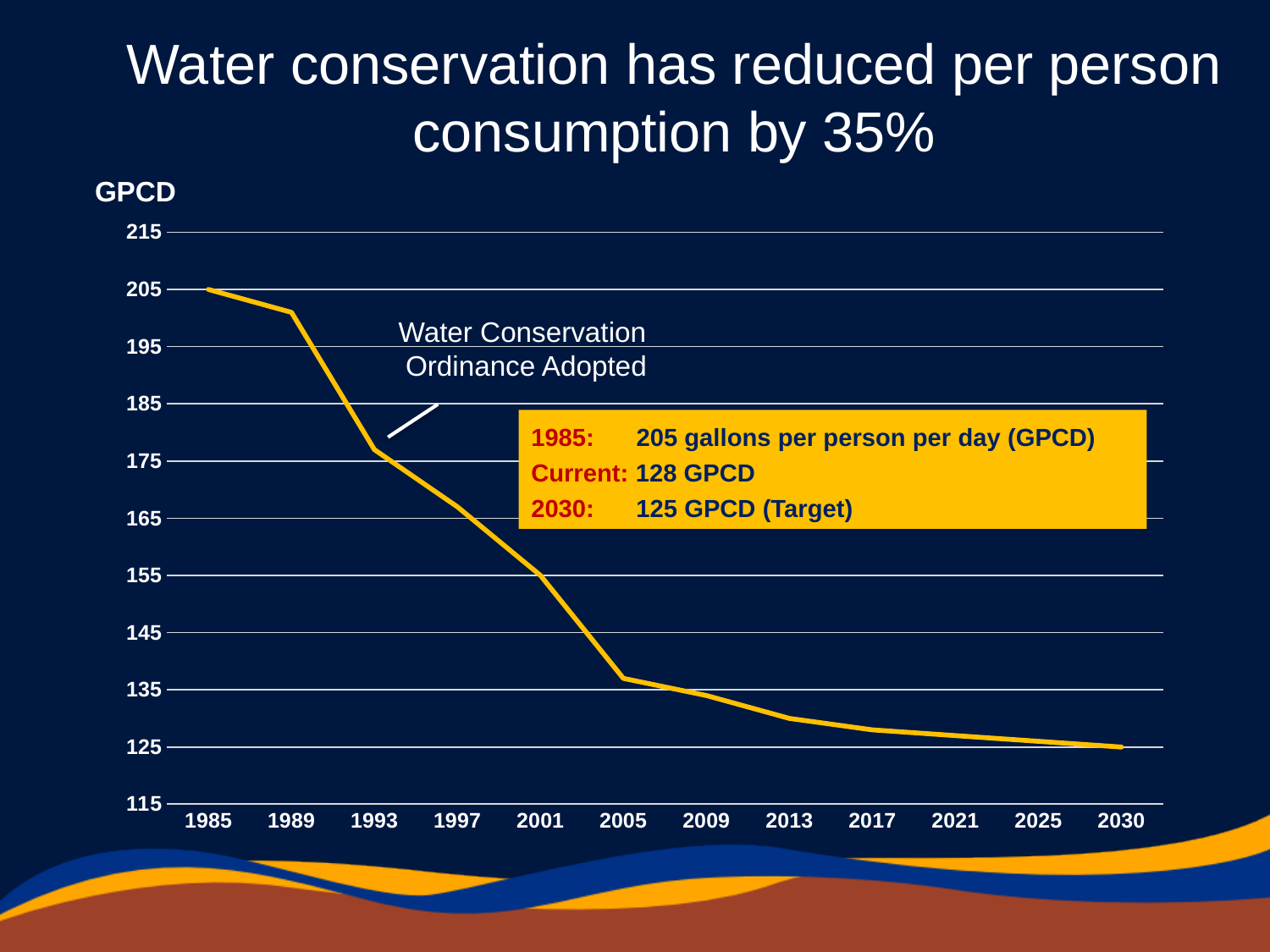
What kind of chart is shown on the slide? line chart Which year has the highest value on the chart? 1985 Is the value for 1989 greater or less than 195? greater What was the per person water consumption in 1985? 205 GPCD Which is larger, the value for 1989 or the value for 2005? 1989 What is the target per person water consumption for 2030? 125 GPCD Do the values rise or fall from 1985 to 2030? fall Which year has the lowest value on the chart? 2030 Is the value for 2001 greater or less than 165? less How many year labels are shown on the x axis? 12 What label is shown on the y axis of the chart? GPCD What is the difference between the 1985 value and the 2030 target value? 80 GPCD